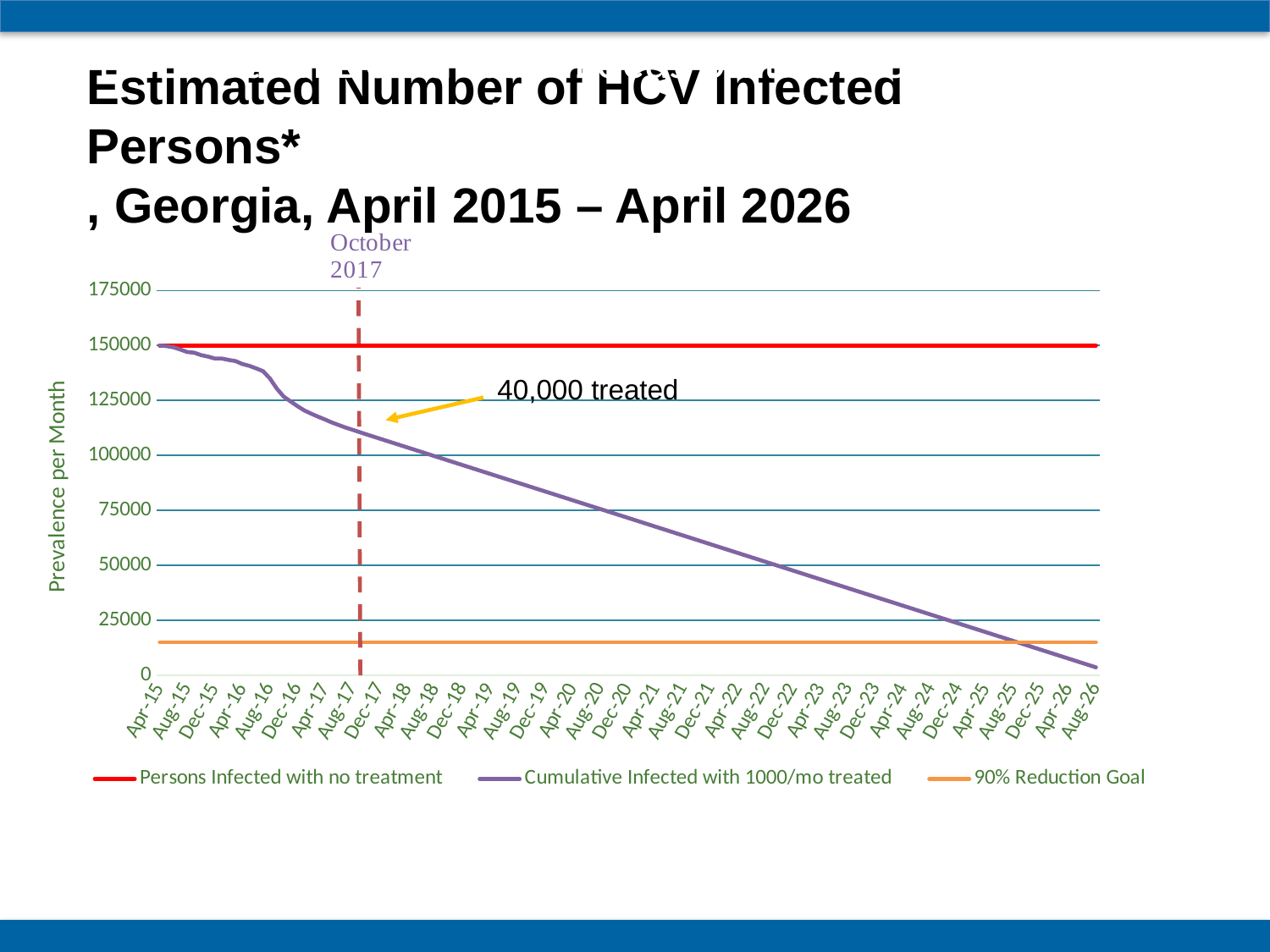
What is the value of the 'Persons Infected with no treatment' line? 150000 How many series does the legend list? 3 Is the value of the '90% Reduction Goal' line greater or less than 25000? less What kind of chart is shown on the slide? line chart Does the 'Cumulative Infected with 1000/mo treated' line rise or fall from Apr-15 to Aug-26? fall What month and year does the dashed vertical line mark? October 2017 Which series has the highest value at Apr-24? Persons Infected with no treatment What is the label on the y axis? Prevalence per Month Is the value of 'Cumulative Infected with 1000/mo treated' at Apr-16 greater or less than 125000? greater Is the value of 'Cumulative Infected with 1000/mo treated' at Dec-17 greater or less than 125000? less At Aug-26, which is larger: 'Persons Infected with no treatment' or 'Cumulative Infected with 1000/mo treated'? Persons Infected with no treatment